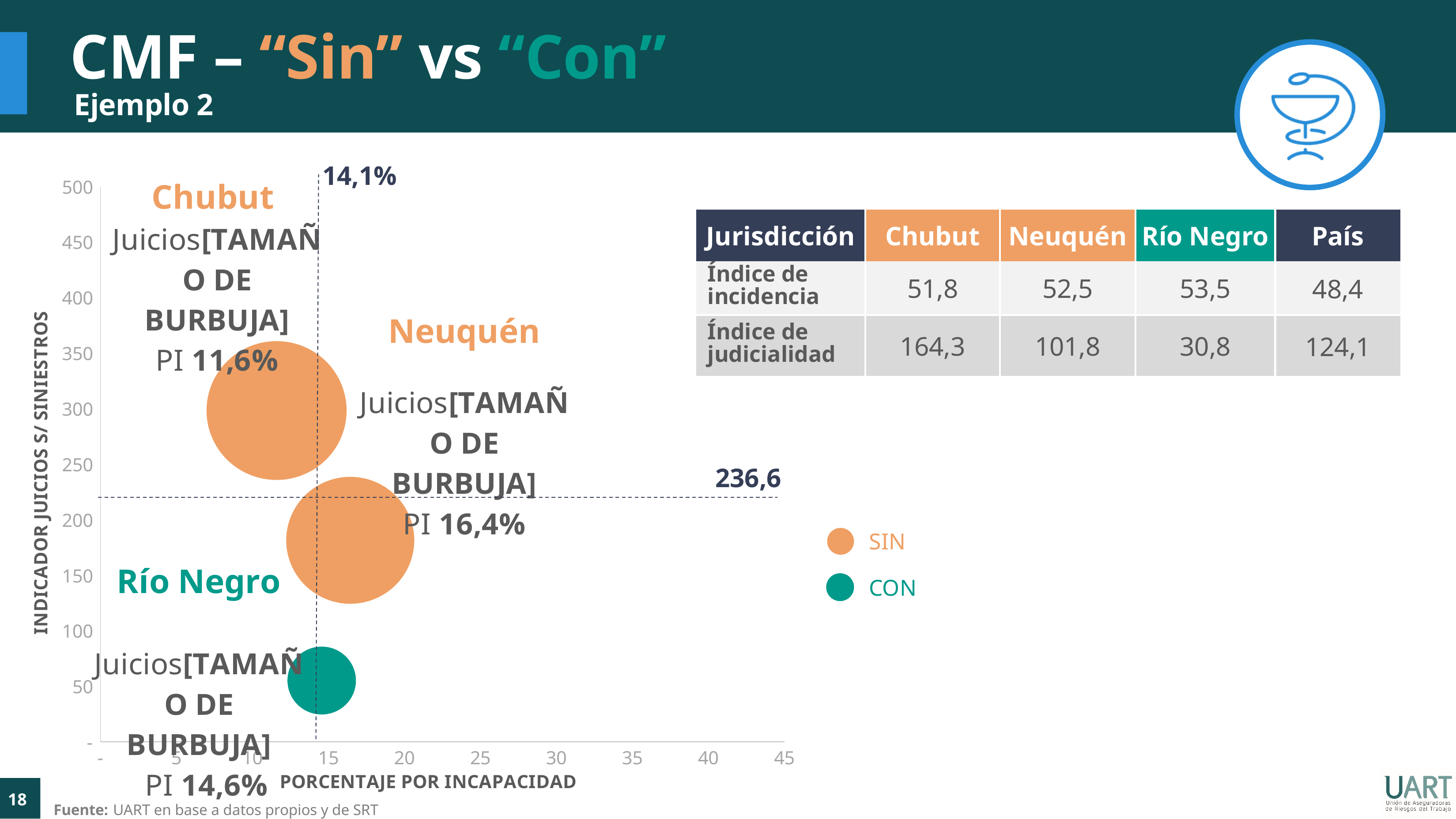
How many bubbles (jurisdictions) are plotted on the chart? 3 Is the Indicador Juicios s/ Siniestros value for Chubut greater or less than 250? greater What is the PI value labelled for Neuquén? 16,4% Is the Indicador Juicios s/ Siniestros value for Río Negro greater or less than 100? less What kind of chart is shown on the slide? Bubble chart Which jurisdiction has the highest labelled PI value? Neuquén What value is labelled on the horizontal dashed reference line of the chart? 236,6 What is the PI (porcentaje por incapacidad) value labelled for Chubut? 11,6% How many series does the chart legend list? 2 What is the difference between the PI values of Neuquén and Chubut? 4,8 percentage points Which jurisdiction has the lowest labelled PI value? Chubut What is the PI value labelled for Río Negro? 14,6%